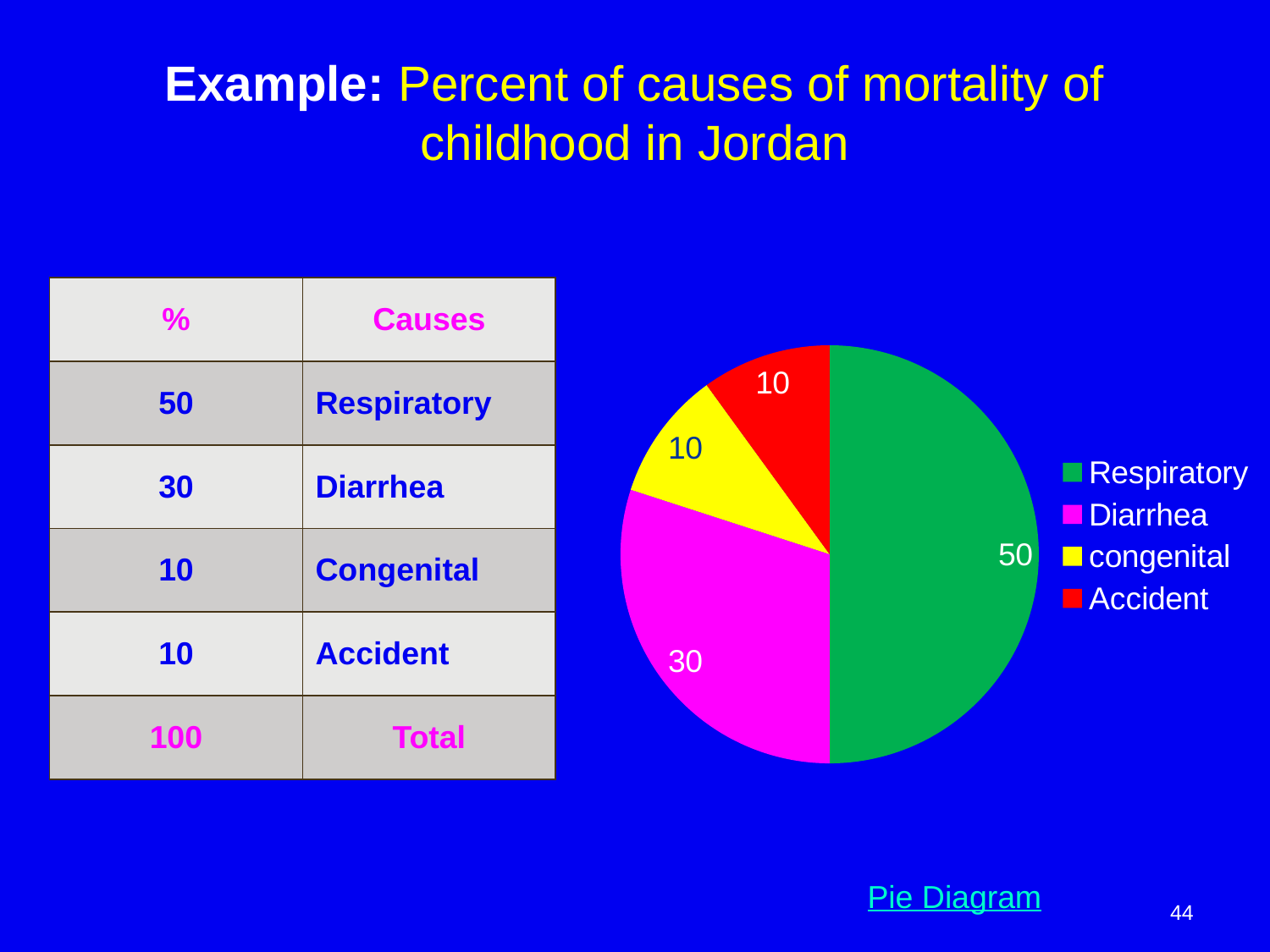
Which is larger in the pie chart, Diarrhea or congenital? Diarrhea What colour is the Diarrhea slice in the pie chart? magenta What is the value shown for Diarrhea in the pie chart? 30 What is the difference between the Respiratory and Diarrhea values in the pie chart? 20 How many entries does the legend of the pie chart list? 4 What is the value shown for Accident in the pie chart? 10 What share of the pie does the Respiratory slice represent? 50% Which legend entry is shown in green in the pie chart? Respiratory What kind of chart is shown on the slide? pie chart Which cause has the largest slice in the pie chart? Respiratory How many slices does the pie chart have? 4 What is the value shown for Respiratory in the pie chart? 50